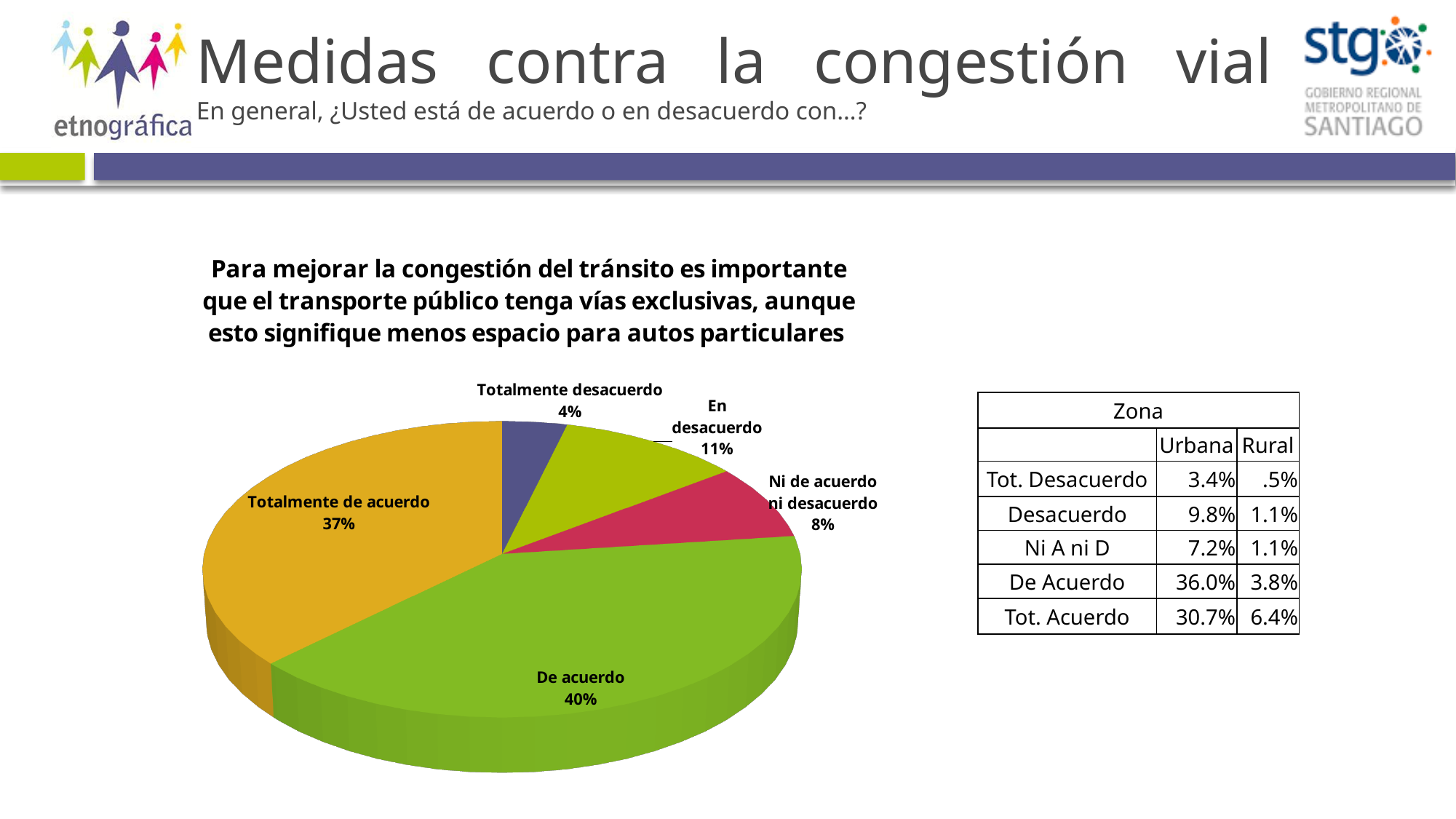
What is the difference in percentage points between "De acuerdo" and "Totalmente de acuerdo"? 3 percentage points How many slices does the pie chart have? 5 Which is larger, the share for "En desacuerdo" or the share for "Ni de acuerdo ni desacuerdo"? En desacuerdo What colour is the "De acuerdo" slice of the pie chart? Green What percentage of respondents answered "Ni de acuerdo ni desacuerdo"? 8% What percentage of respondents answered "Totalmente de acuerdo"? 37% What percentage of respondents answered "Totalmente desacuerdo"? 4% What percentage of respondents answered "De acuerdo"? 40% What type of chart is shown on the slide? Pie chart What percentage of respondents answered "En desacuerdo"? 11% Which response category has the smallest share of the pie? Totalmente desacuerdo Which response category has the largest share of the pie? De acuerdo